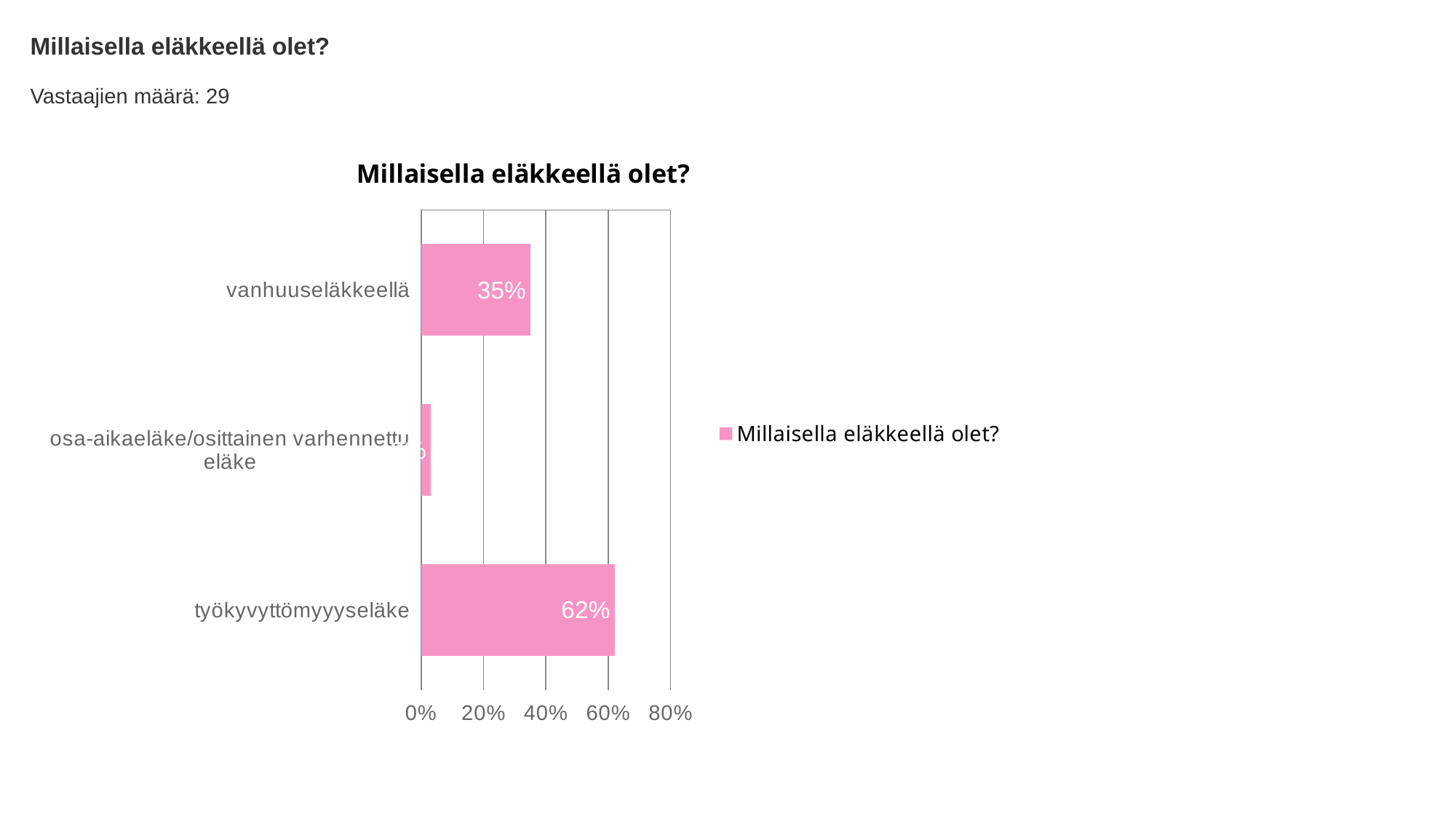
What is the value for vanhuuseläkkeellä? 35% Is the value for osa-aikaeläke/osittainen varhennettu eläke greater or less than 20%? less What kind of chart is shown on the slide? bar chart Which category has the highest value? työkyvyttömyyyseläke What is the difference between the values for työkyvyttömyyseläke and vanhuuseläkkeellä? 27% What is the title of the chart? Millaisella eläkkeellä olet? Which category has the lowest value? osa-aikaeläke/osittainen varhennettu eläke Is the value for työkyvyttömyyseläke greater or less than 60%? greater How many categories are shown in the chart? 3 How many series does the legend list? 1 What is the value for työkyvyttömyyseläke? 62% Which is larger, the value for vanhuuseläkkeellä or the value for työkyvyttömyyseläke? työkyvyttömyyyseläke